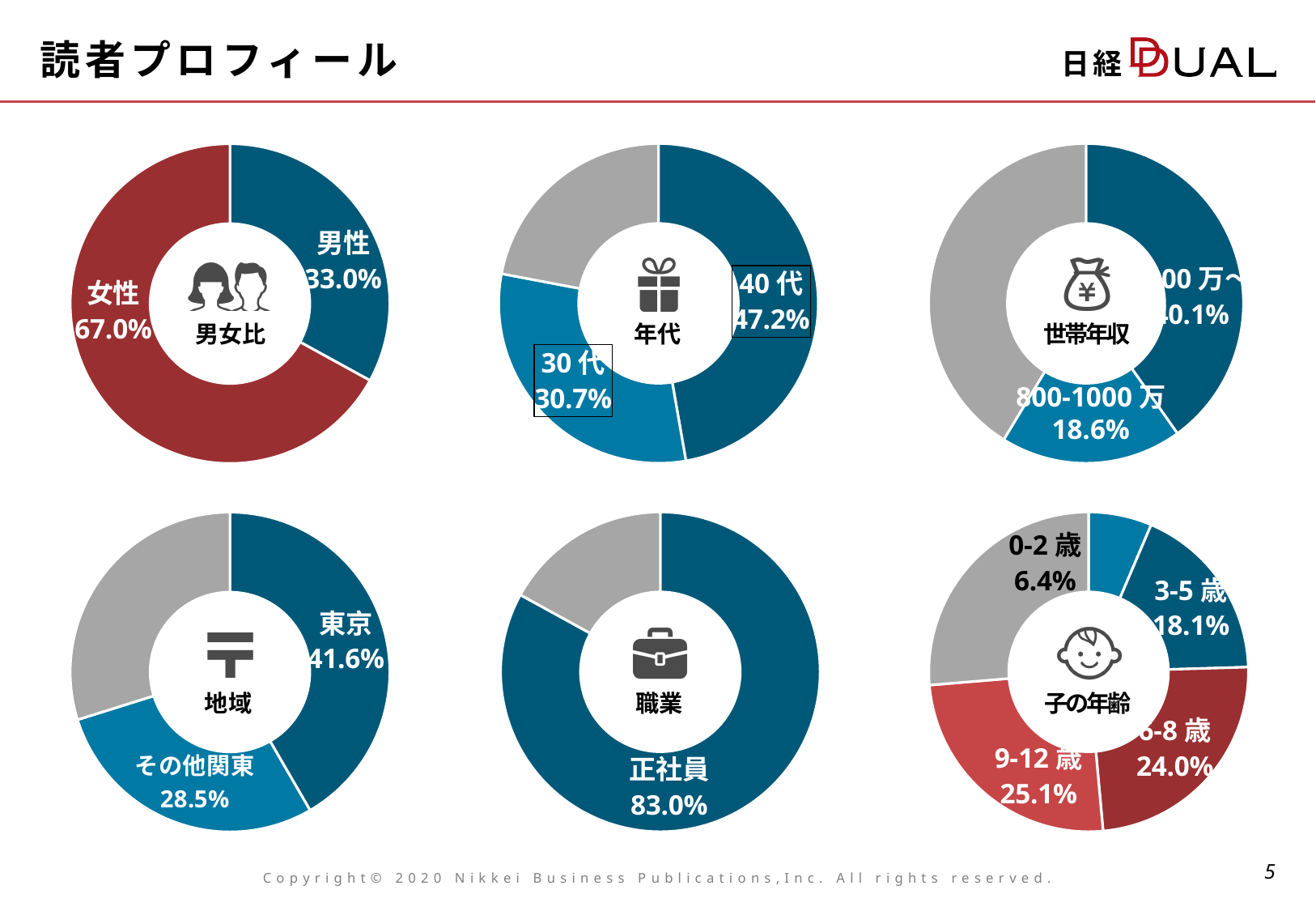
In the 男女比 chart, what percentage is 女性? 67.0% In the 地域 chart, what is the difference between 東京 and その他関東? 13.1% In the 年代 chart, what percentage is 40代? 47.2% In the 世帯年収 chart, what percentage is 800-1000万? 18.6% In the 子の年齢 chart, what percentage is 9-12歳? 25.1% In the 地域 chart, what percentage is 東京? 41.6% In the 職業 chart, what percentage is 正社員? 83.0% What kind of chart is used for 男女比? Donut (pie) chart In the 男女比 chart, what percentage is 男性? 33.0% In the 年代 chart, which is larger, 30代 or 40代? 40代 In the 男女比 chart, what is the difference between the 女性 and 男性 shares? 34.0% In the 子の年齢 chart, which labelled age group has the smallest share? 0-2歳